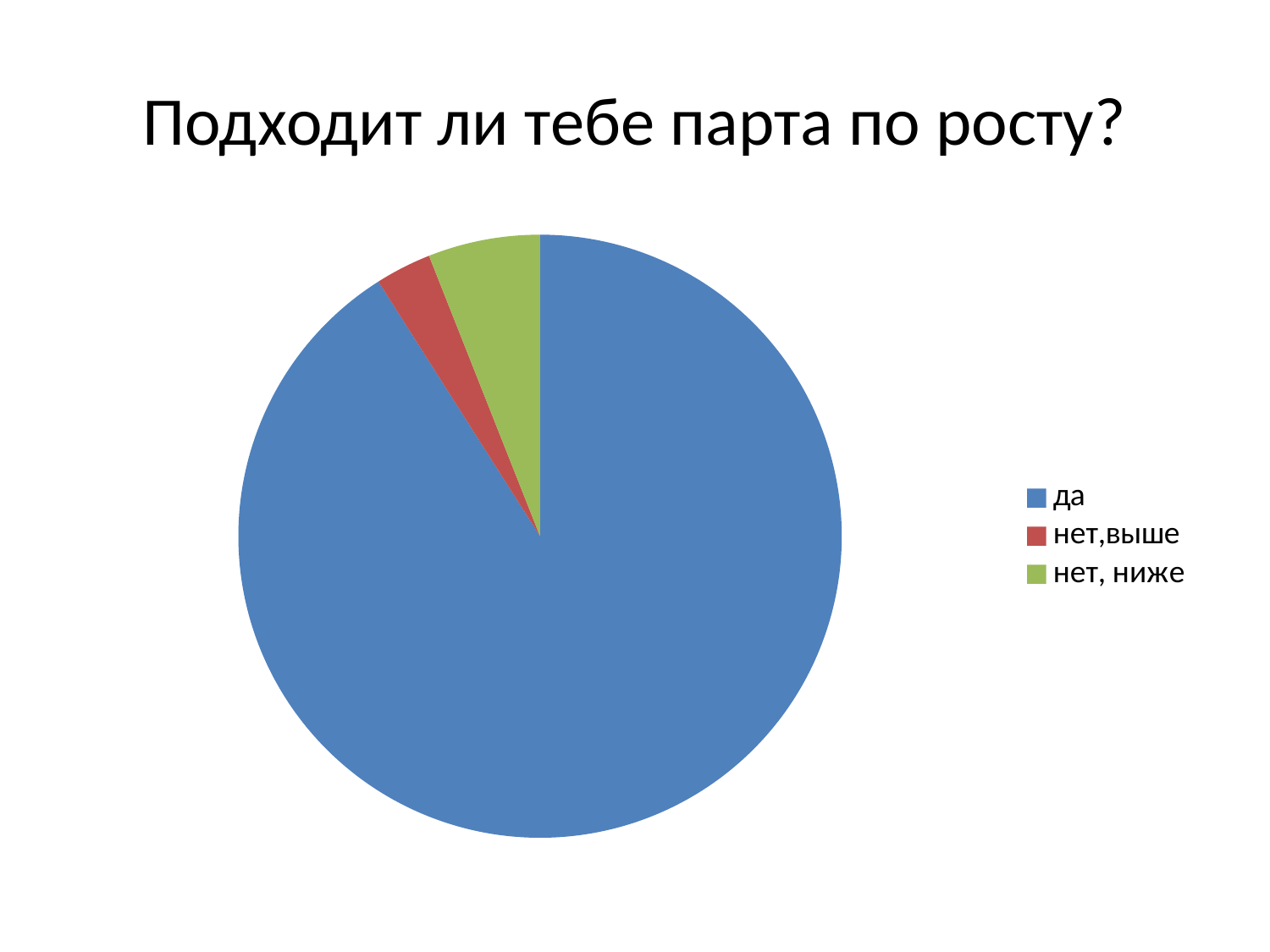
What colour is the slice for "да"? blue Which slice is larger, "да" or "нет, ниже"? да What kind of chart is shown on the slide? pie chart Which slice is larger, "нет, ниже" or "нет,выше"? нет, ниже How many entries does the legend list? 3 How many slices does the pie chart have? 3 What is the title of the chart? Подходит ли тебе парта по росту? Which category has the largest slice of the pie? да Which category has the smallest slice of the pie? нет,выше